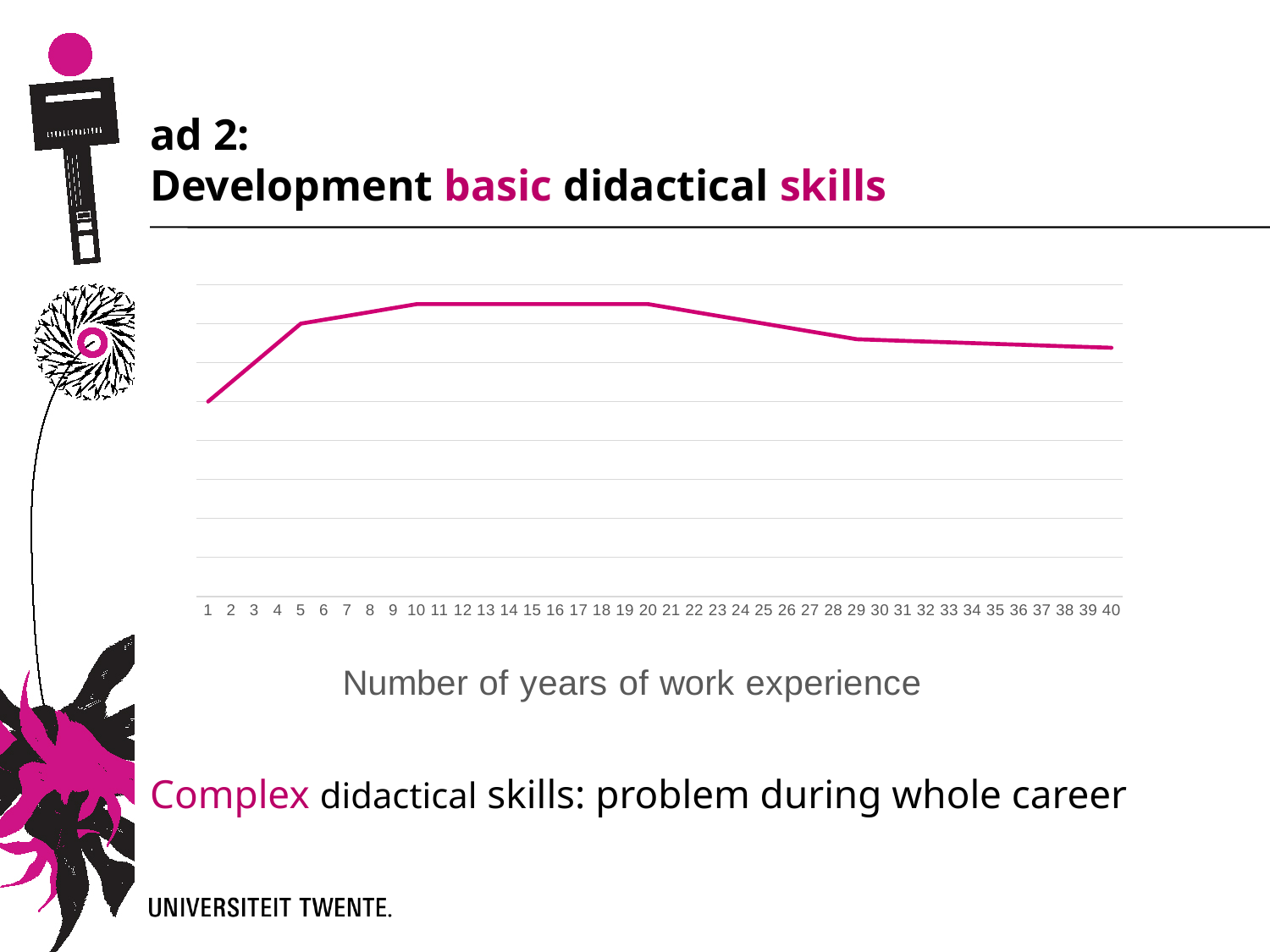
Does the line rise or fall between x = 10 and x = 20? neither, it stays flat Is the value at x = 15 higher or lower than the value at x = 35? higher Does the line rise or fall between x = 1 and x = 10? rise How many points are labelled along the x axis of the chart? 40 How many lines are plotted in the chart? 1 What kind of chart is shown on the slide? line chart Is the value at x = 1 higher or lower than the value at x = 40? lower What colour is the plotted line in the chart? pink (magenta) Is the value at x = 5 higher or lower than the value at x = 2? higher Does the line rise or fall between x = 20 and x = 40? fall What is the label of the x axis of the chart? Number of years of work experience At which x-axis value is the plotted line at its lowest point? 1